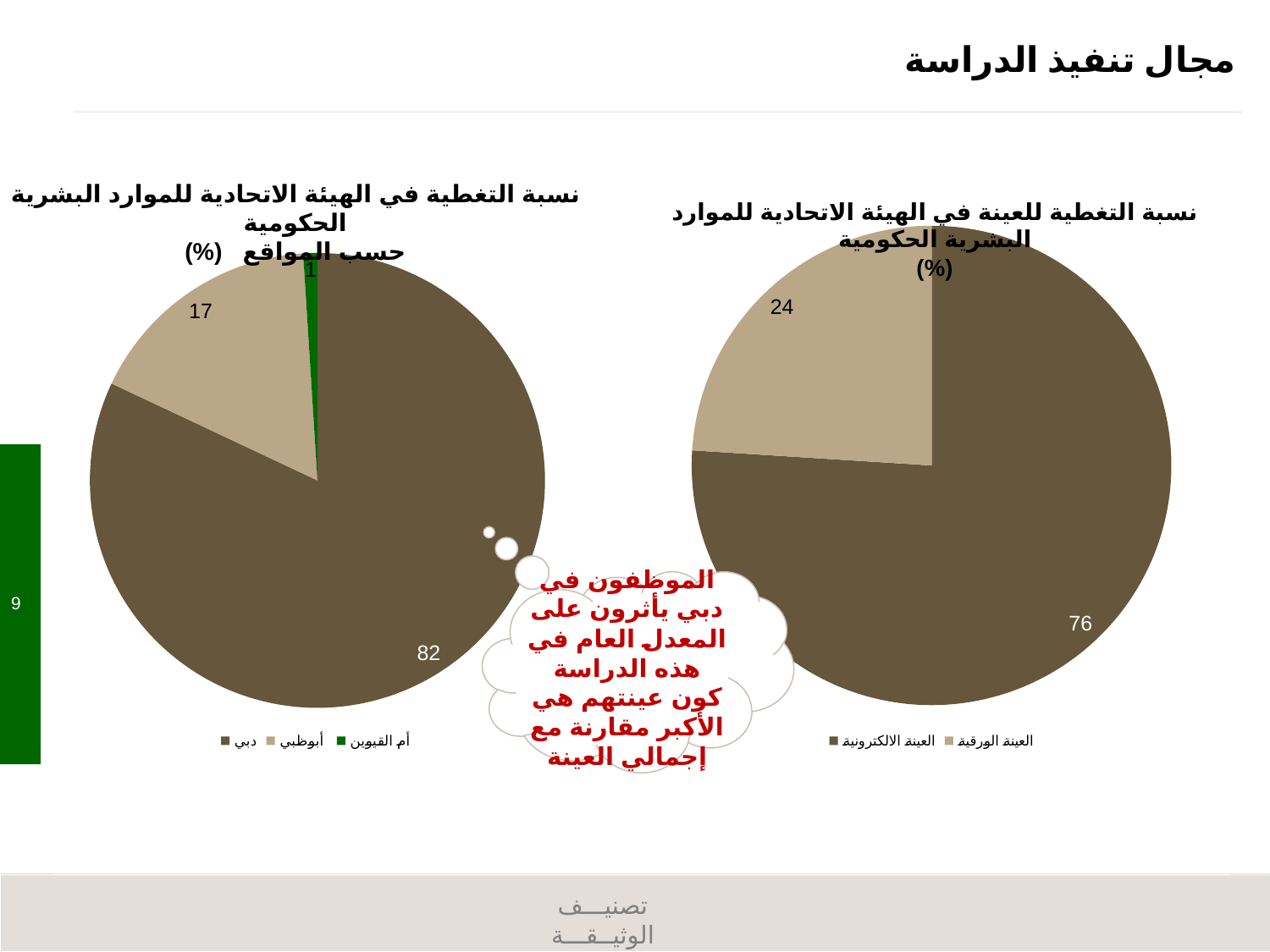
In the left pie chart, which location has the smallest slice? أم القيوين In the left pie chart (حسب المواقع), what is the value for أبوظبي? 17 In the right pie chart (نسبة التغطية للعينة), what is the value for العينة الالكترونية? 76 What type of chart is used for the left chart (حسب المواقع)? Pie chart How many series does the legend of the right pie chart list? 2 In the right pie chart (نسبة التغطية للعينة), what is the value for العينة الورقية? 24 In the left pie chart (حسب المواقع), what is the value for دبي? 82 In the right pie chart, which slice is larger, العينة الالكترونية or العينة الورقية? العينة الالكترونية In the left pie chart, what is the difference between دبي and أبوظبي? 65 In the left pie chart, which location has the largest slice? دبي In the left pie chart (حسب المواقع), what is the value for أم القيوين? 1 In the right pie chart, what is the difference between العينة الالكترونية and العينة الورقية? 52